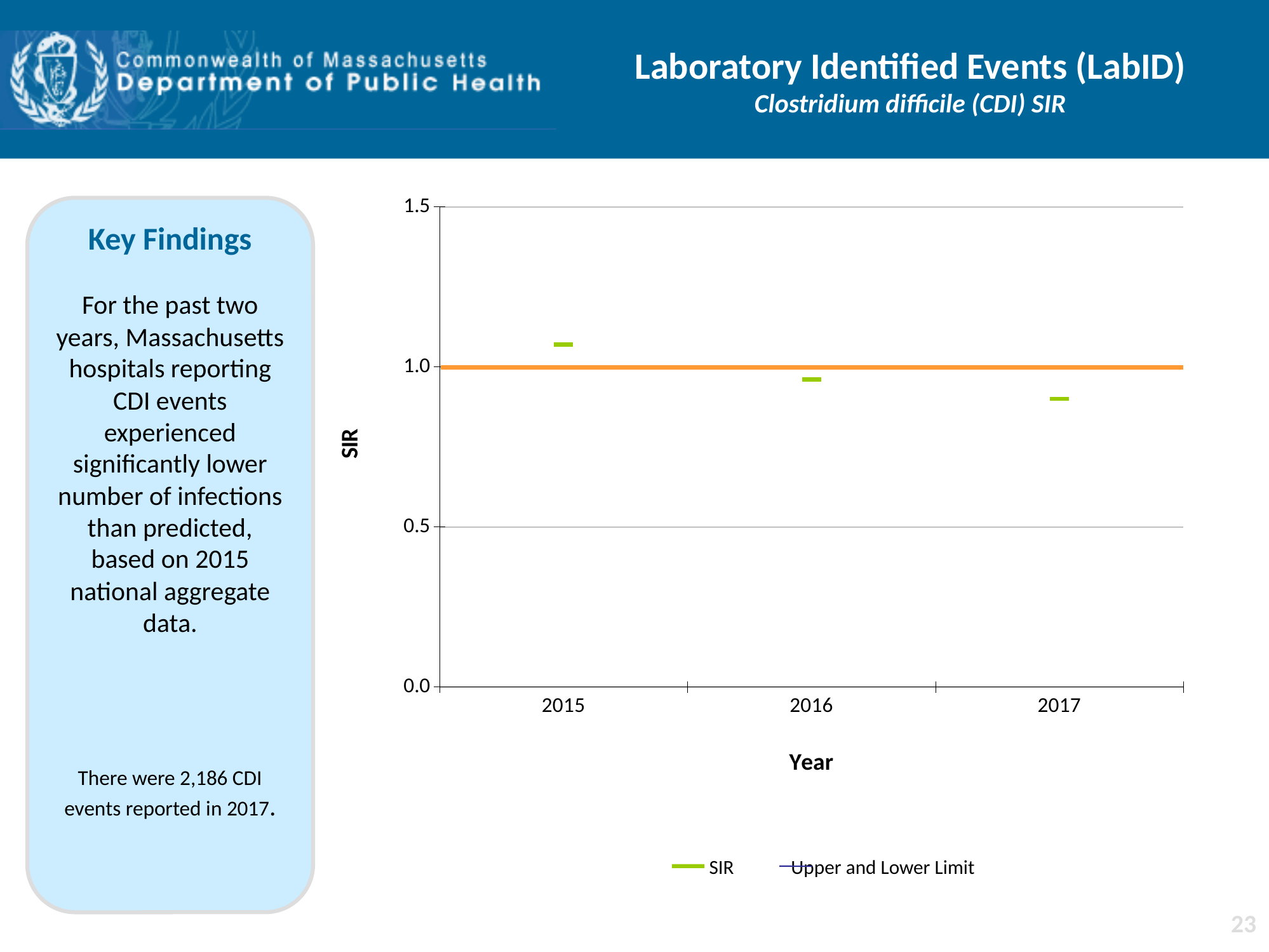
Which year has the larger SIR value, 2015 or 2017? 2015 Is the SIR value for 2017 greater or less than 0.5? greater How many years are plotted on the x axis? 3 Which year has the highest SIR value? 2015 Is the SIR value for 2017 greater or less than 1.0? less Do the SIR values rise or fall from 2015 to 2017? fall How many series does the legend list? 2 What is the title of the x axis? Year Is the SIR value for 2016 greater or less than 1.0? less Which year has the lowest SIR value? 2017 What is the title of the y axis? SIR